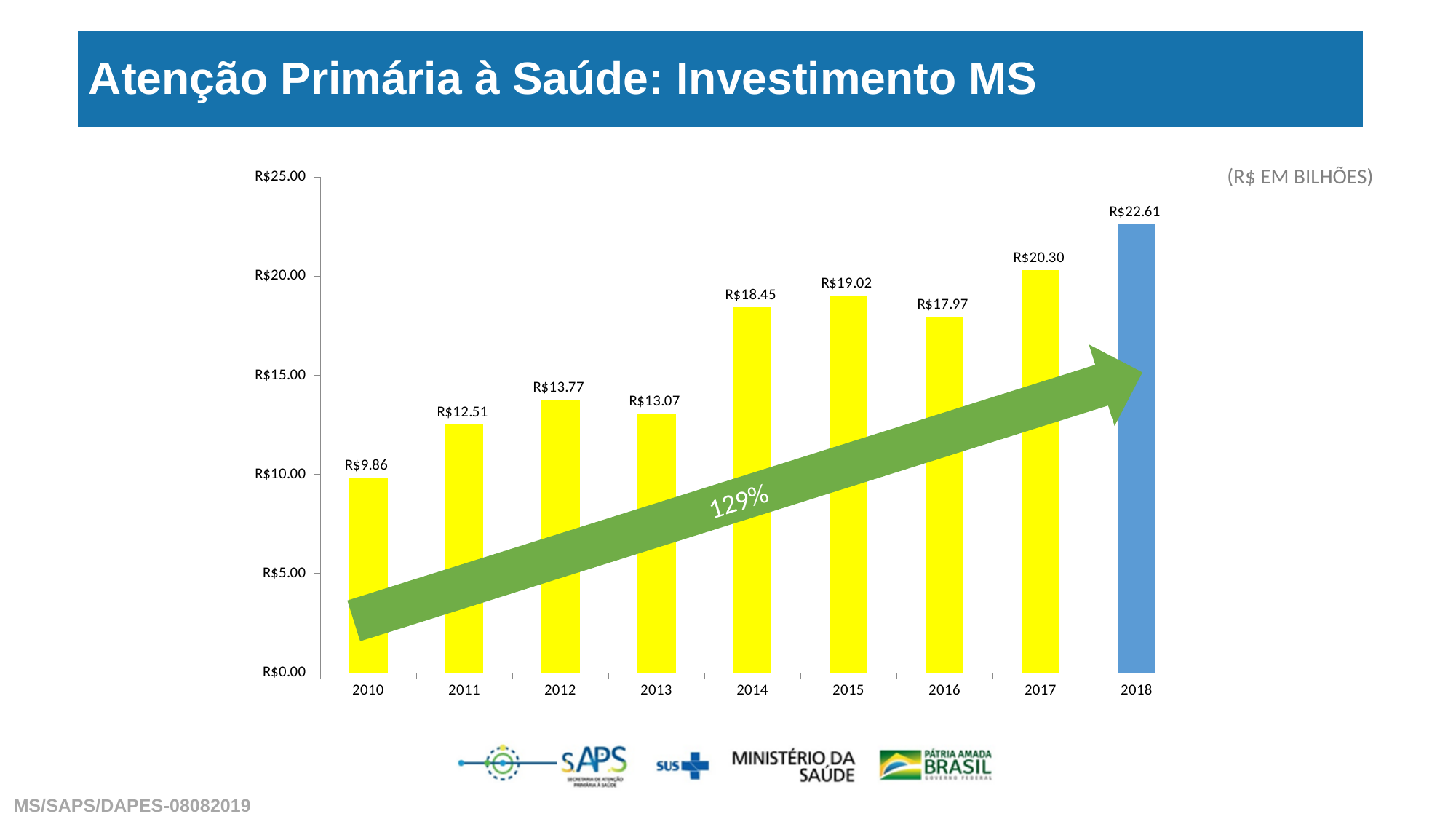
How many years are shown on the x axis? 9 Is the value for 2017 greater or less than R$20.00? greater What is the value for 2010? R$9.86 What is the difference between the values for 2018 and 2010? R$12.75 What percentage is written on the green arrow? 129% Which year has the lowest value? 2010 What is the value for 2018? R$22.61 Which year has the highest value? 2018 What is the value for 2014? R$18.45 Do the values generally rise or fall from 2010 to 2018? rise What kind of chart is shown on the slide? bar chart Which is larger, the value for 2015 or the value for 2016? 2015